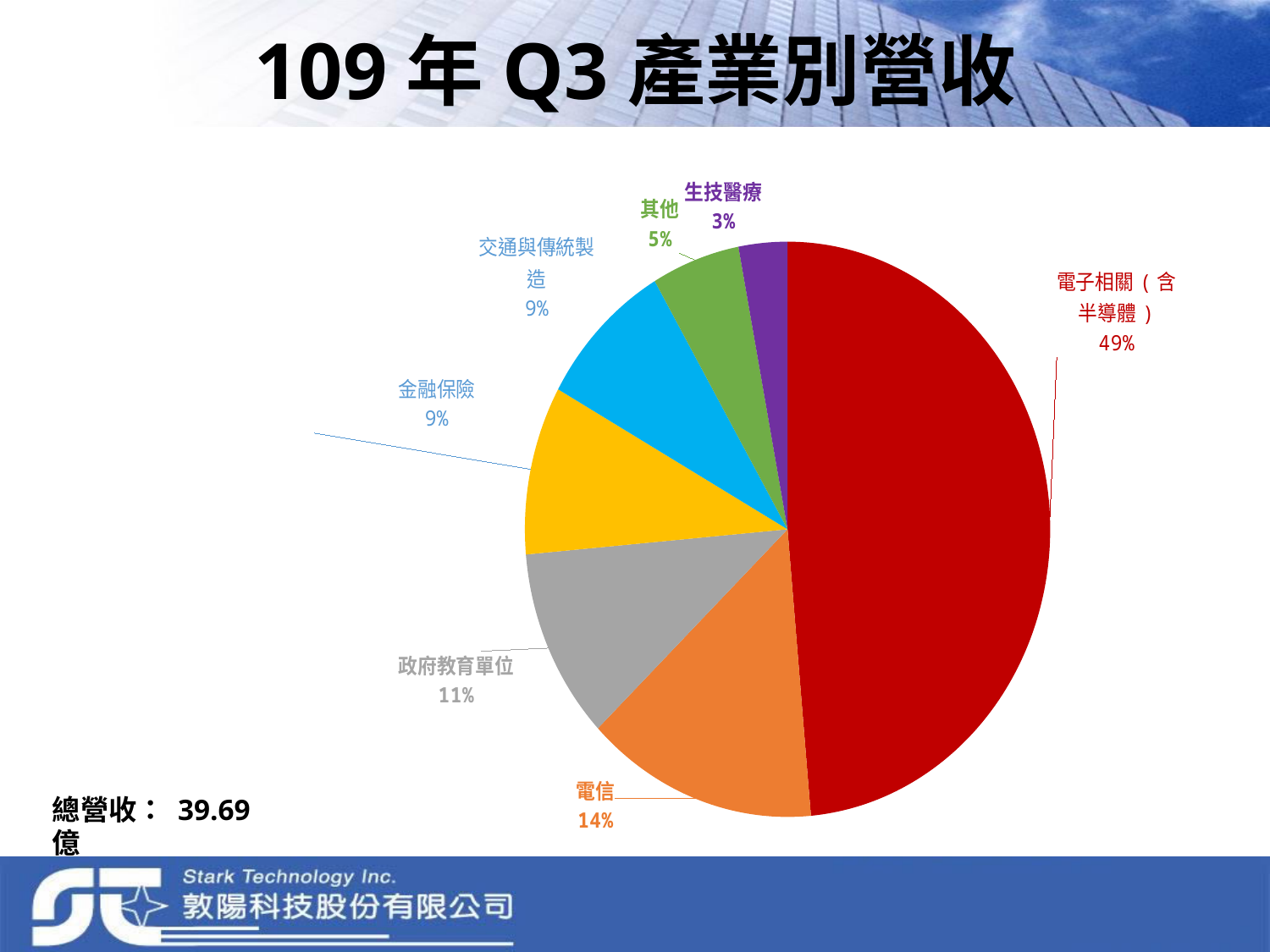
Which category has the smallest slice of the pie? 生技醫療 What percentage is shown for 生技醫療? 3% What is the difference in percentage points between 電信 and 政府教育單位? 3 What kind of chart is shown on the slide? pie chart What total revenue (總營收) is stated on the slide? 39.69 億 Which category has the largest slice of the pie? 電子相關（含半導體） What is the title of the slide? 109 年 Q3 產業別營收 What percentage is shown for 電信? 14% What share of revenue does 電子相關（含半導體） account for? 49% What percentage is shown for 政府教育單位? 11% How many categories are shown in the pie chart? 7 Which is larger, the share for 其他 or the share for 生技醫療? 其他